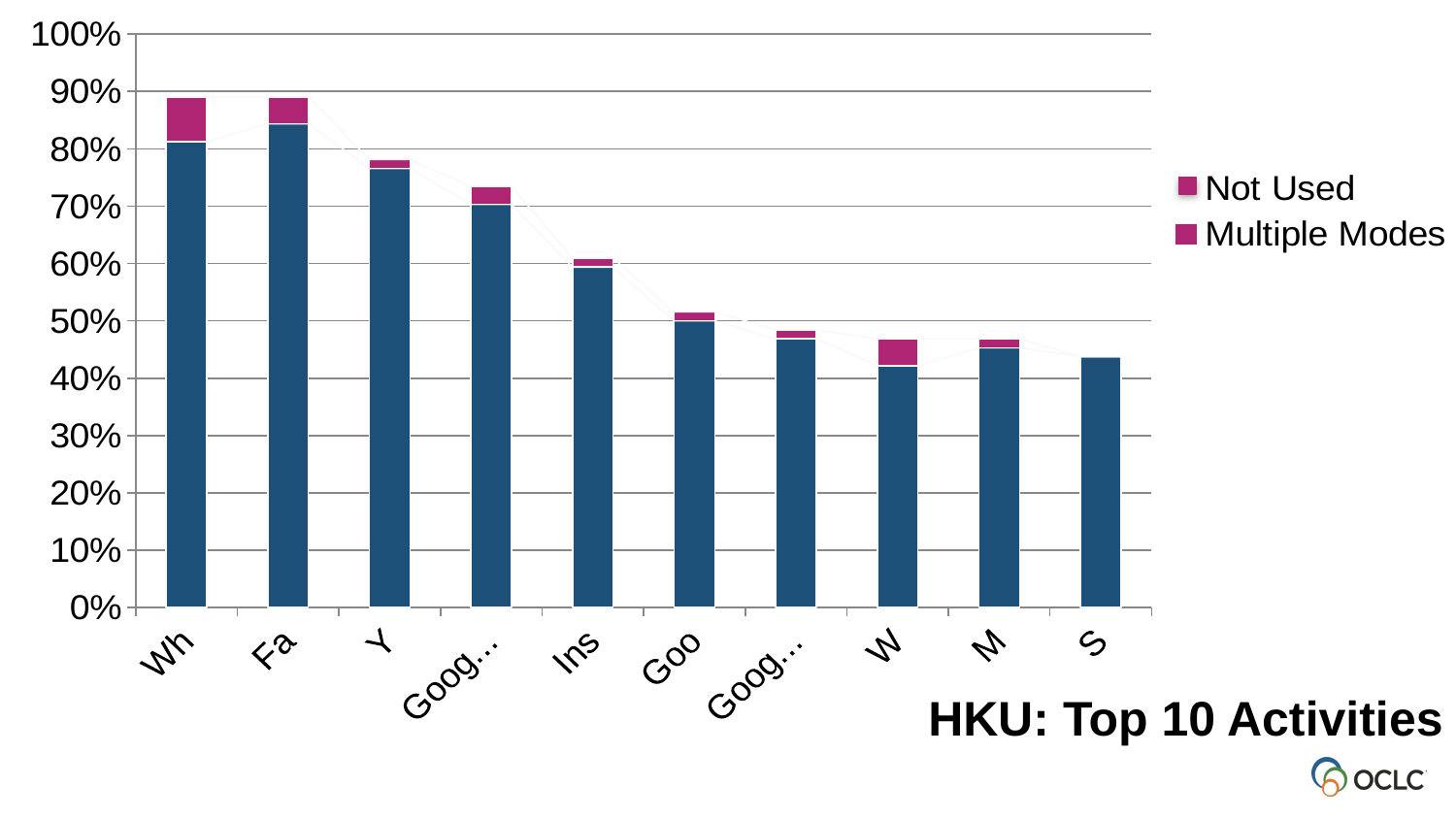
Is the "Multiple Modes" value for "W" greater or less than 50%? less Is the total height of the bar for "M" greater or less than 50%? less Is the total height of the bar for "S" greater or less than 50%? less How many series does the legend list? 2 Do the bar heights generally rise or fall from left to right along the x axis? Fall What kind of chart is shown on the slide? Stacked bar chart How many bars (categories) are plotted in the chart? 10 What is the title of the chart? HKU: Top 10 Activities